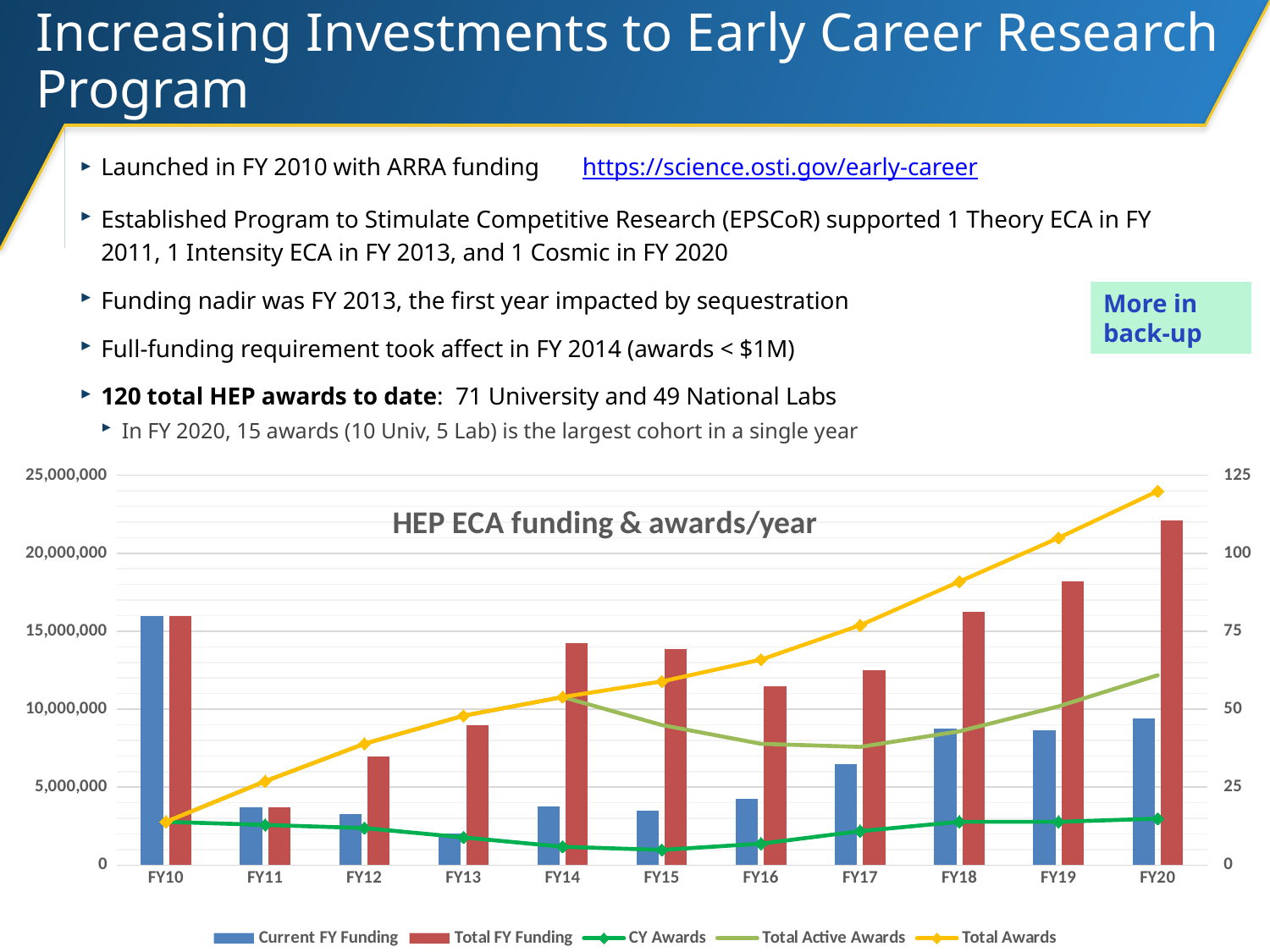
Which fiscal year has the highest Current FY Funding bar? FY10 How many fiscal years are shown along the x axis of the chart? 11 Which fiscal year has the lowest Total FY Funding bar? FY11 Is the Total FY Funding value for FY20 greater or less than 20,000,000? greater Which is larger, the Total FY Funding for FY14 or for FY16? FY14 What is the title of the chart on the slide? HEP ECA funding & awards/year How many series does the chart's legend list? 5 Which fiscal year has the highest Total FY Funding bar? FY20 Does the Total Awards line rise or fall from FY10 to FY20? Rises What kind of chart is shown on the slide? Combined bar and line chart Is the Current FY Funding value for FY17 greater or less than 5,000,000? greater Which fiscal year has the lowest Current FY Funding bar? FY13